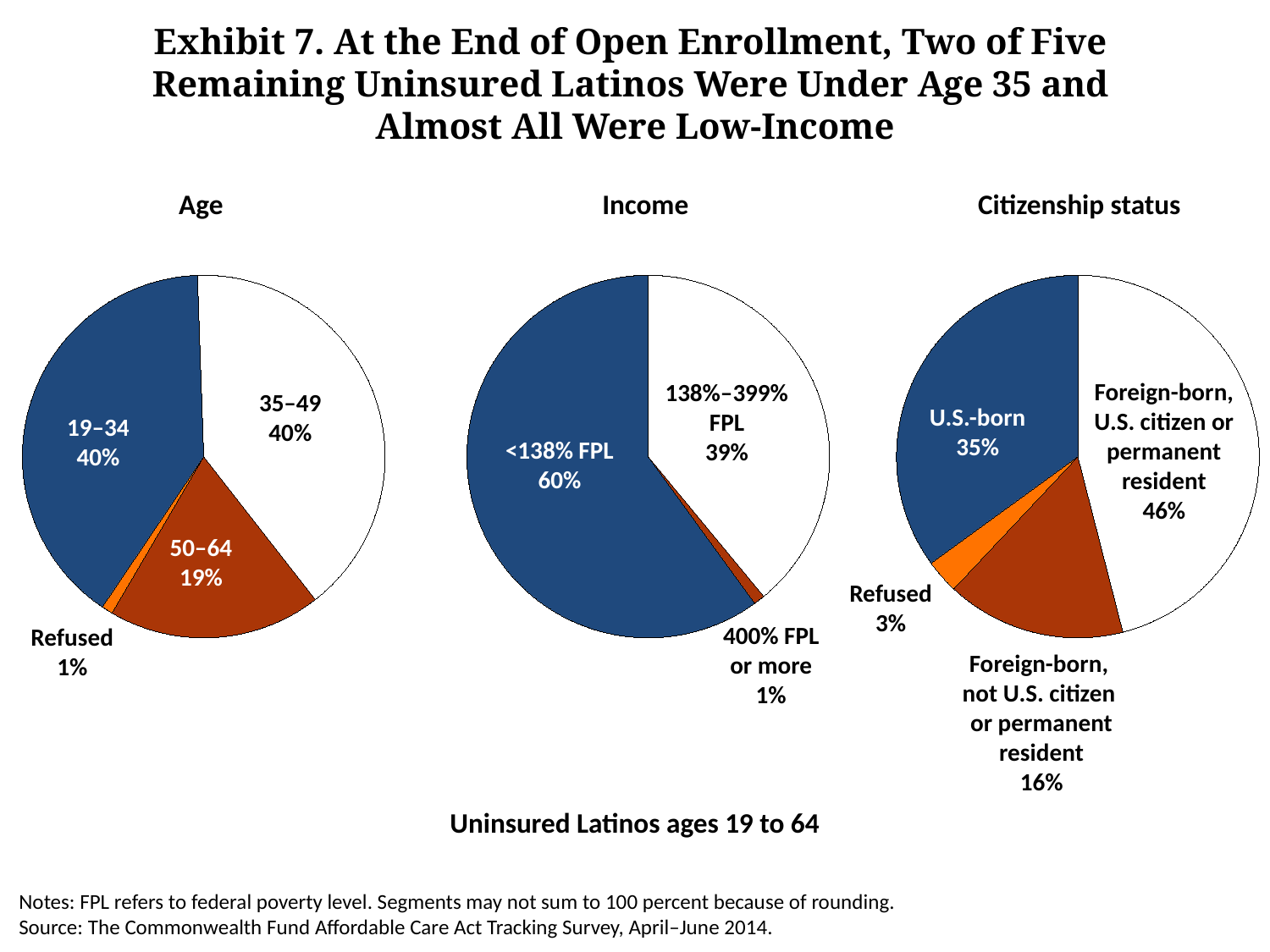
In the Age pie chart, what share of uninsured Latinos are ages 50–64? 19% In the Income pie chart, what share of uninsured Latinos have income below 138% FPL? 60% In the Age pie chart, what share of uninsured Latinos are ages 19–34? 40% What type of chart is used to show the Age breakdown? Pie chart In the Income pie chart, which category has the smallest share? 400% FPL or more In the Citizenship status pie chart, what is the difference between the U.S.-born share and the foreign-born, not U.S. citizen or permanent resident share? 19 percentage points How many segments does the Citizenship status pie chart have? 4 In the Income pie chart, what share have income of 400% FPL or more? 1% How many pie charts are shown on the slide? 3 In the Income pie chart, which is larger: the share below 138% FPL or the share at 138%–399% FPL? <138% FPL In the Citizenship status pie chart, which category has the largest share? Foreign-born, U.S. citizen or permanent resident In the Citizenship status pie chart, what share are foreign-born, not U.S. citizen or permanent resident? 16%